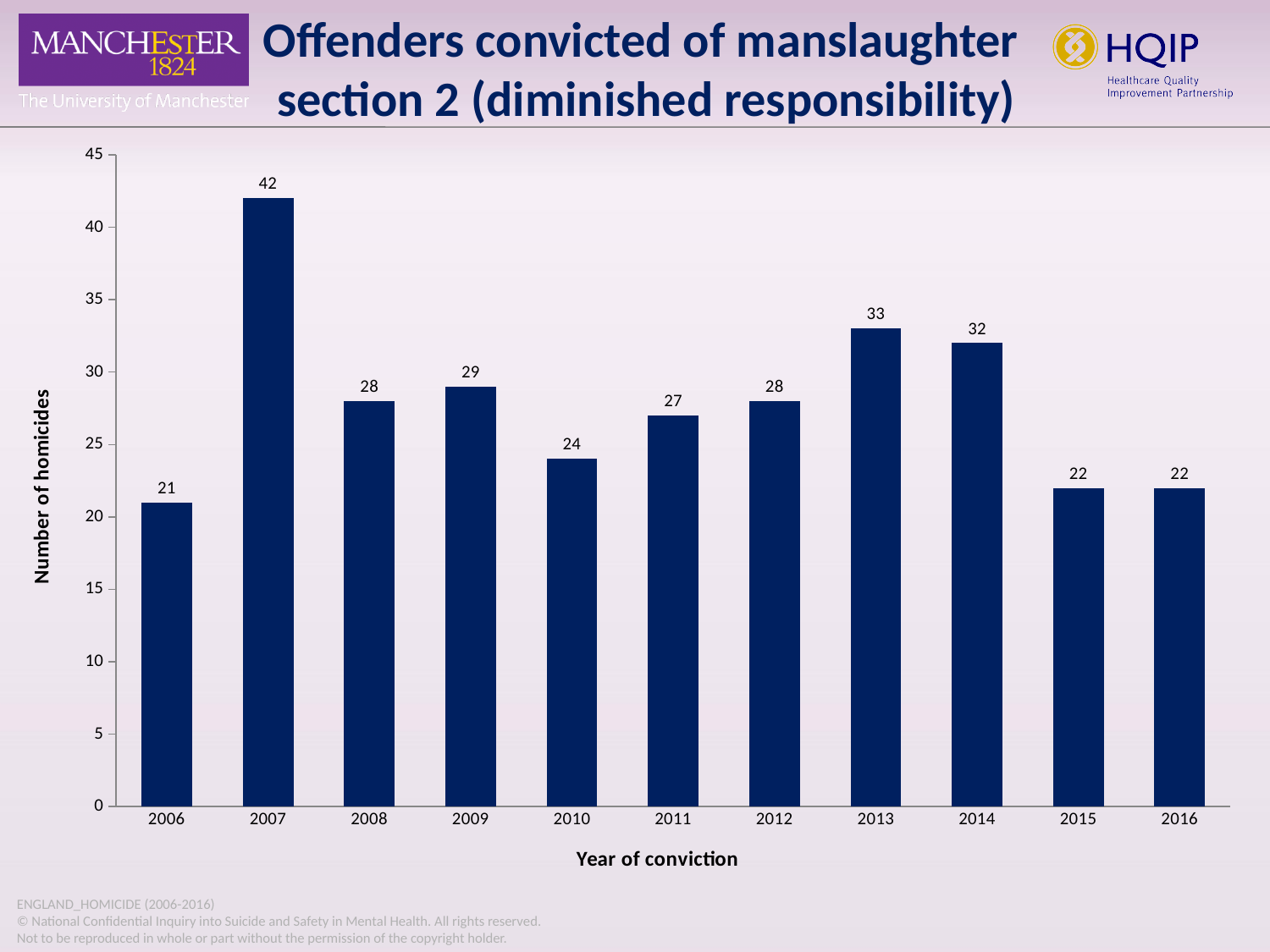
How many years are shown on the x axis? 11 Which year has the lowest number of homicides? 2006 What is the difference between the number of homicides in 2007 and 2006? 21 What is the label of the y axis? Number of homicides What is the difference between the number of homicides in 2013 and 2015? 11 Which year has more homicides, 2009 or 2011? 2009 Which year has the highest number of homicides? 2007 Is the value for 2013 greater or less than 30? greater What kind of chart is shown on the slide? Bar chart What is the number of homicides for 2014? 32 What is the number of homicides for 2007? 42 What is the number of homicides for 2010? 24